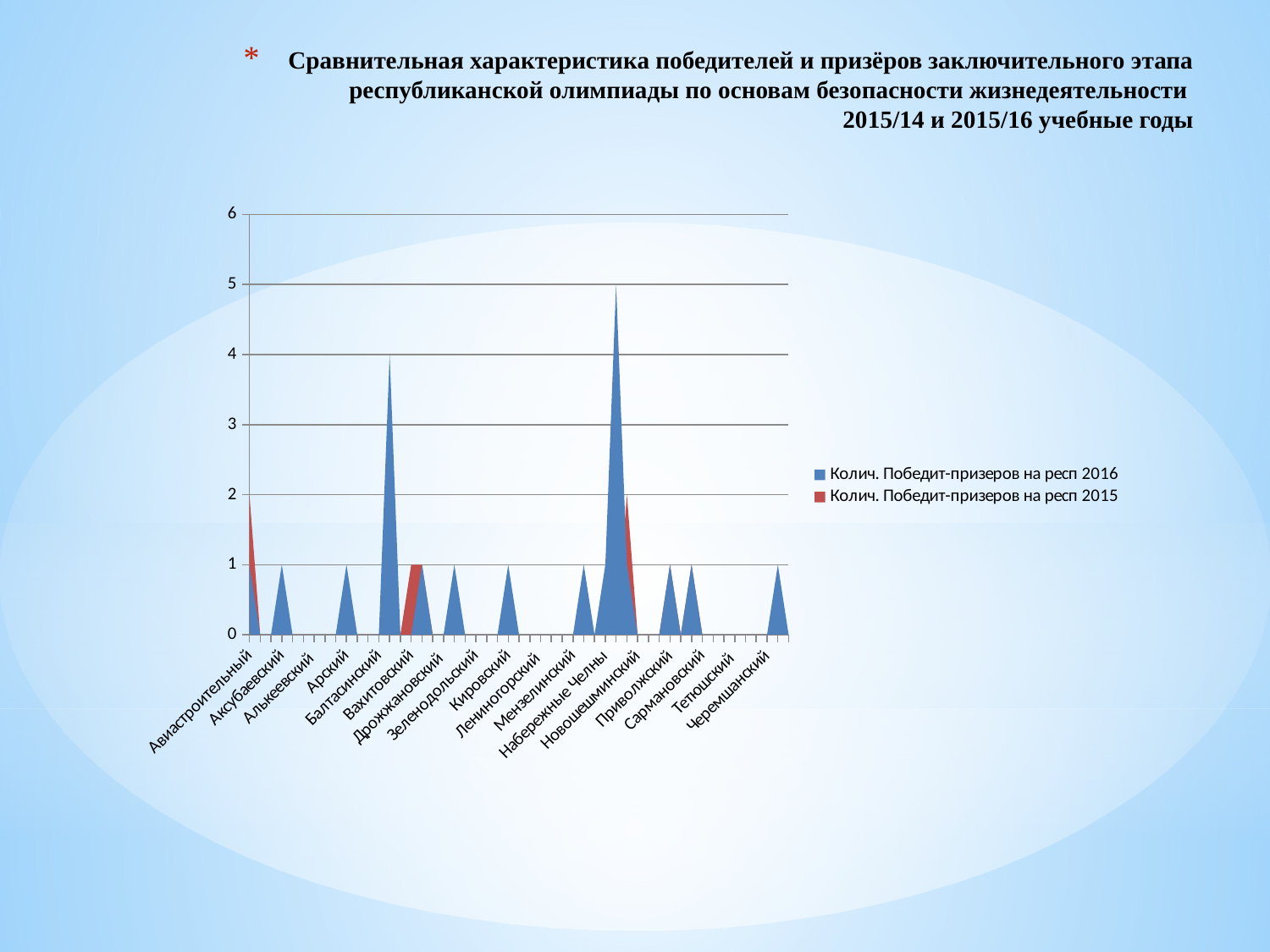
How many series does the legend list? 2 What colour represents the series 'Колич. Победит-призеров на респ 2015'? red What is the highest value shown on the vertical axis? 6 Which is larger for Авиастроительный: the 2016 series value or the 2015 series value? the 2015 series value Is the value for Аксубаевский in the 2016 series greater or less than 2? less What kind of chart is shown on the slide? area chart